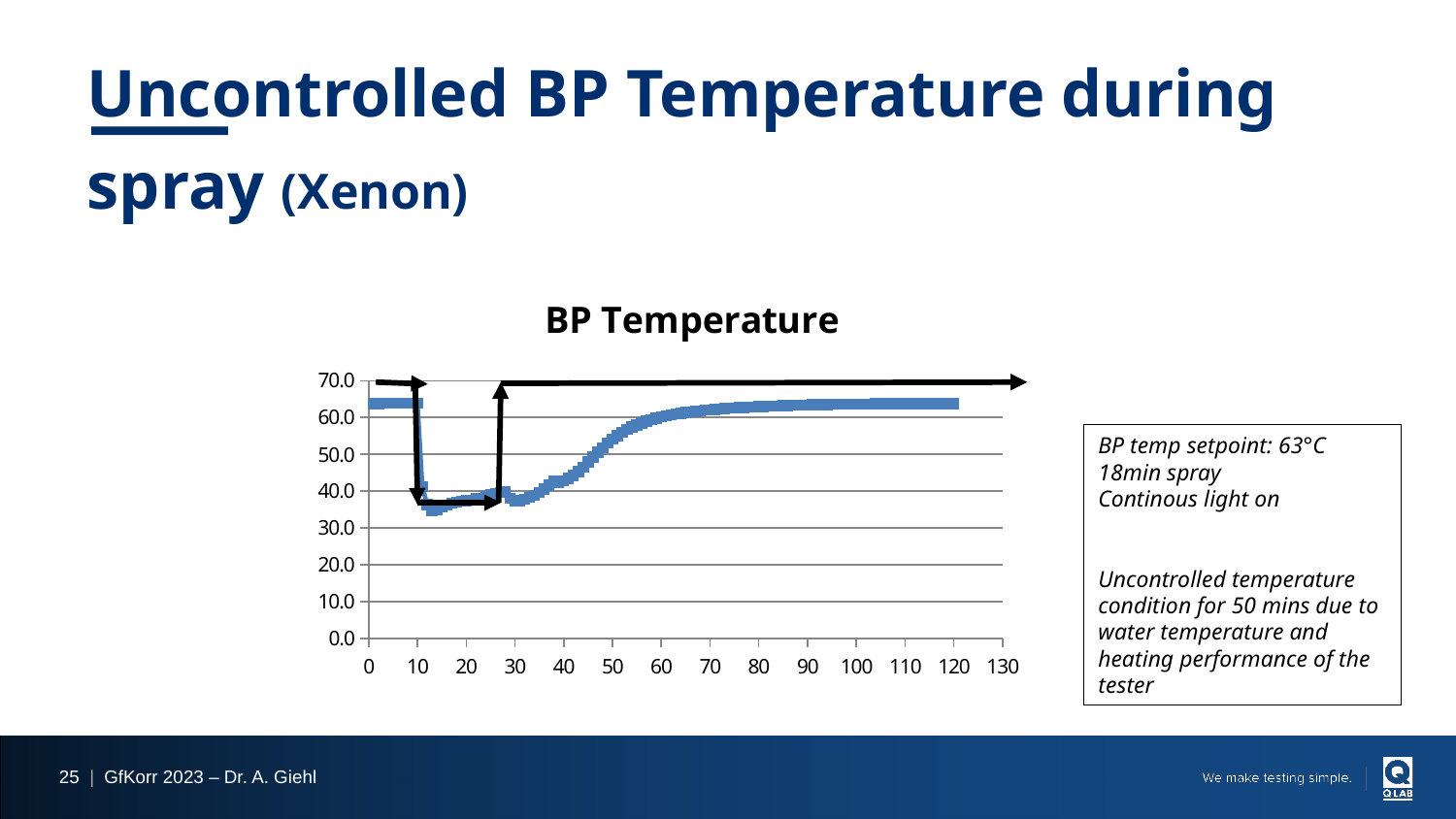
Is the lowest value on the curve greater or less than 30? greater What is the title of the chart? BP Temperature What is the highest value shown on the y axis of the chart? 70.0 Which is larger, the value at x = 0 or the value at x = 20? x = 0 Is the value at x = 40 greater or less than 50? less Between x = 10 and x = 15, do the values rise or fall? fall Is the value at x = 0 greater or less than 60? greater What type of chart is shown on the slide? line chart Between x = 30 and x = 60, do the values rise or fall? rise